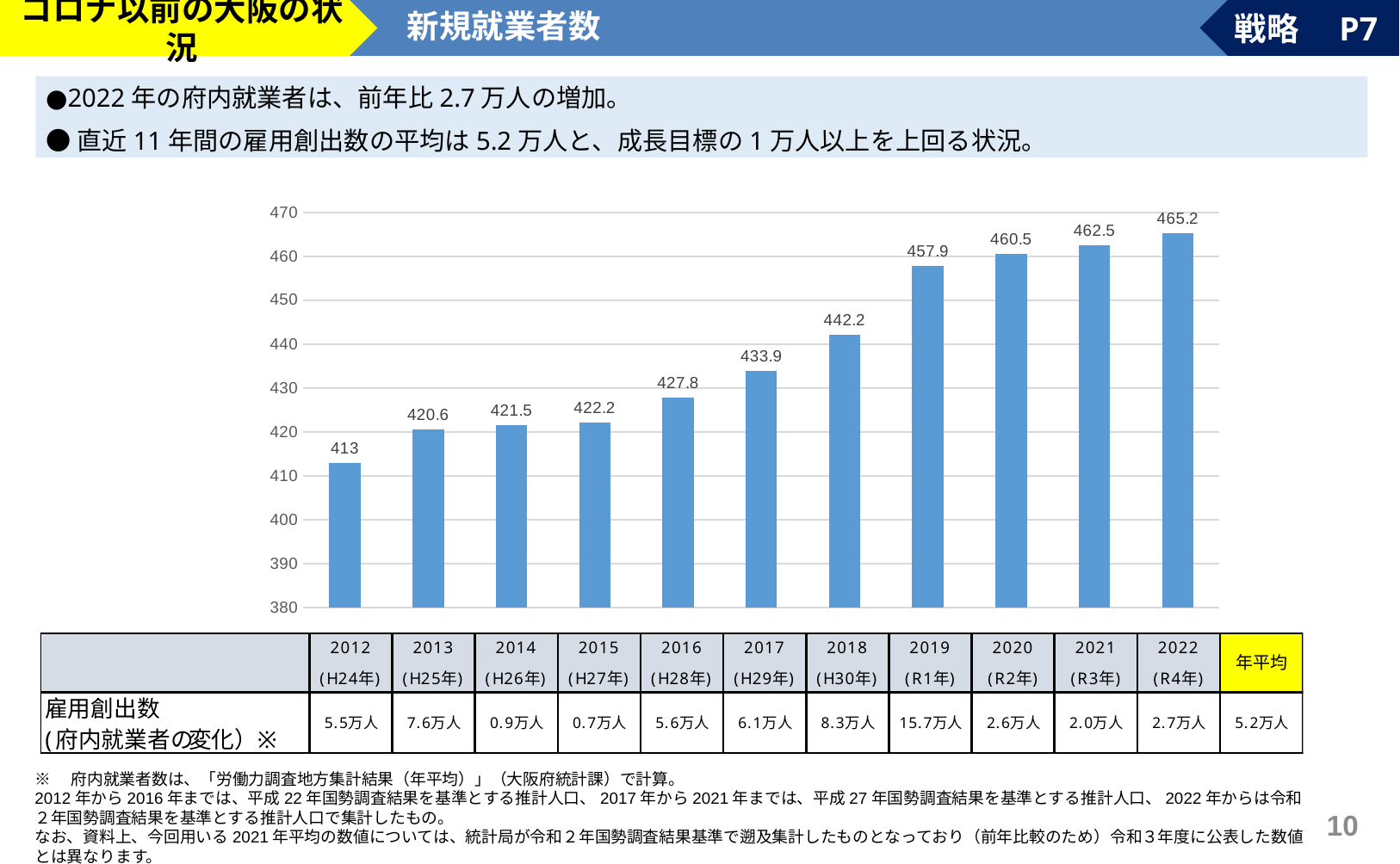
What is the value of the bar for 2016 (H28年)? 427.8 What is the difference between the 2022 value (465.2) and the 2021 value (462.5)? 2.7 How many bars are plotted in the chart? 11 Which is larger, the value for 2018 (442.2) or the value for 2017 (433.9)? 2018 What is the value of the bar for 2022 (R4年)? 465.2 What is the value of the bar for 2012 (H24年)? 413 What type of chart is shown on the slide? bar chart Do the bar values rise or fall from 2012 to 2022? rise What is the value of the bar for 2019 (R1年)? 457.9 Which year has the lowest bar in the chart? 2012 (H24年) What is the title shown in the header bar above the chart? 新規就業者数 Which year has the highest bar in the chart? 2022 (R4年)